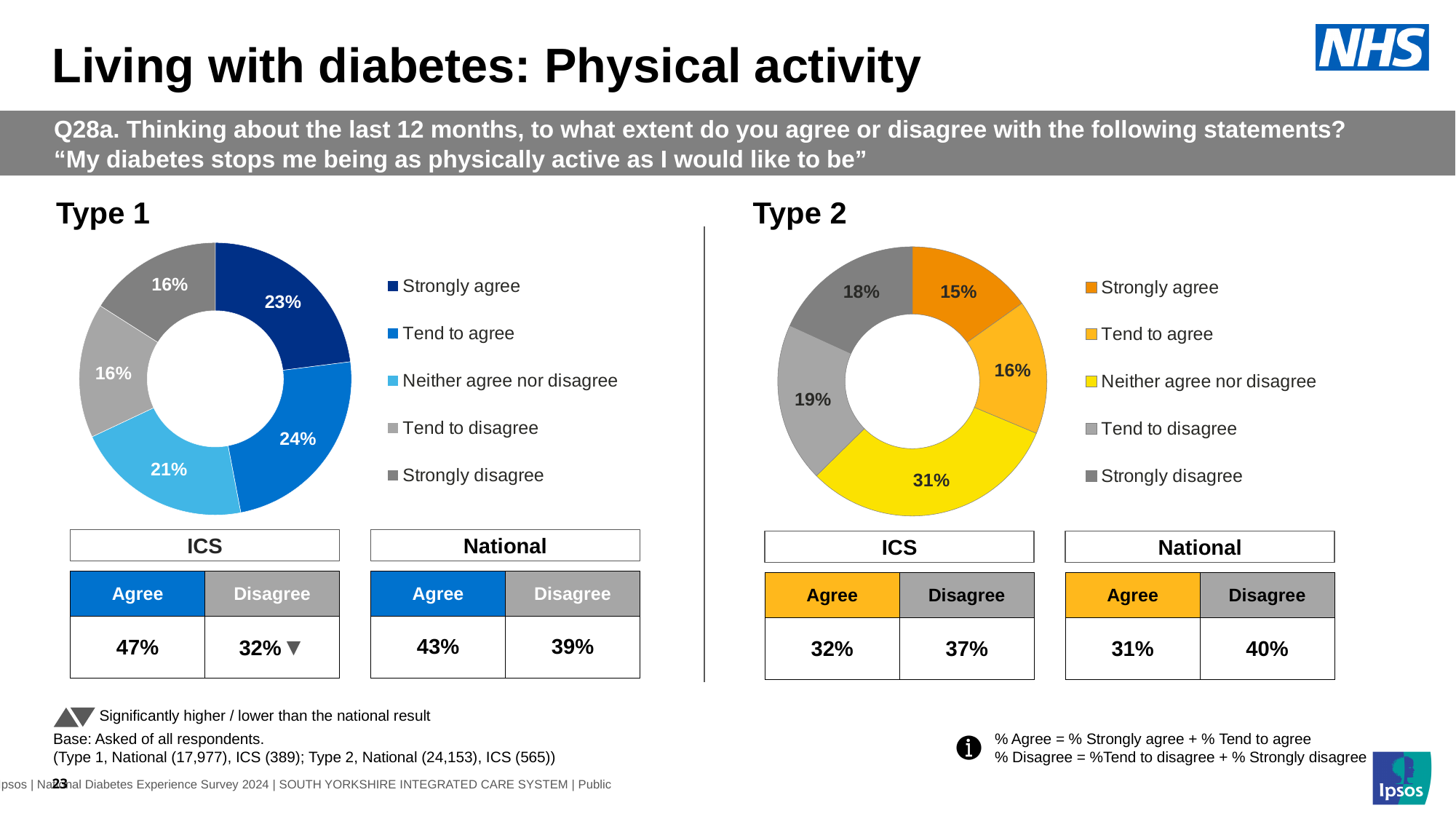
In the Type 2 chart, which is larger: 'Tend to disagree' or 'Tend to agree'? Tend to disagree In the Type 2 chart, what is the difference in percentage points between 'Neither agree nor disagree' and 'Strongly agree'? 16 What kind of chart is used for the Type 2 data? Donut (pie) chart In the Type 1 chart, which is larger: 'Strongly agree' or 'Neither agree nor disagree'? Strongly agree In the Type 2 chart, what percentage of respondents said 'Neither agree nor disagree'? 31% In the Type 1 chart, what percentage of respondents said 'Strongly agree'? 23% How many response categories does the legend of the Type 1 chart list? 5 In the Type 2 chart, what percentage of respondents said 'Tend to disagree'? 19% In the Type 1 chart, what percentage of respondents said 'Neither agree nor disagree'? 21% In the Type 2 chart, what colour is the 'Neither agree nor disagree' segment? Yellow In the Type 1 chart, which response category has the largest share? Tend to agree In the Type 2 chart, which response category has the smallest share? Strongly agree